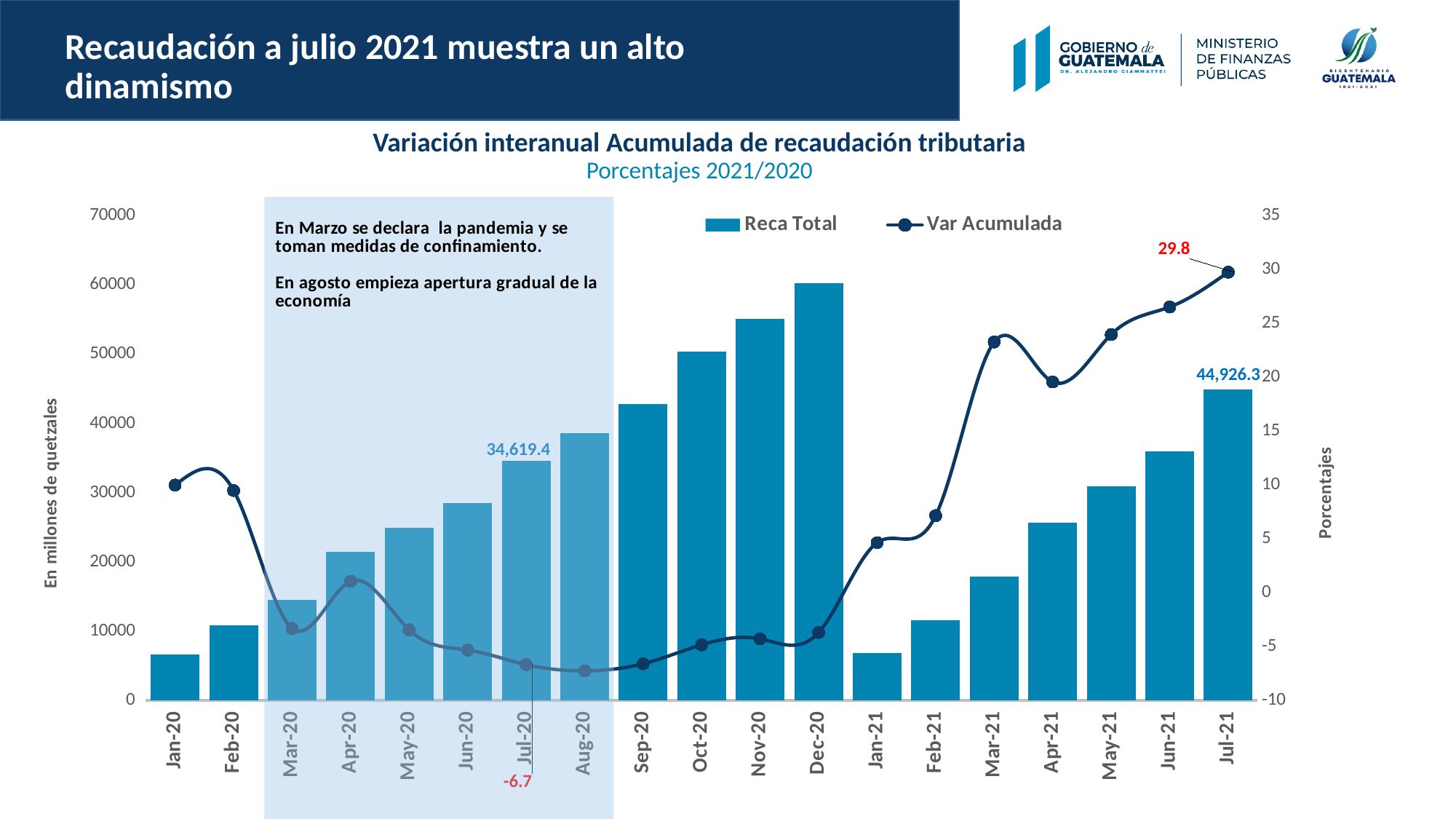
Is the Var Acumulada value for Mar-21 greater or less than 20? greater What is the Var Acumulada value labelled for Jul-21? 29.8 Which has the larger Reca Total bar, Oct-20 or Nov-20? Nov-20 How many months are shown on the x axis? 19 Is the Reca Total value for Dec-20 greater or less than 50000? greater What is the Reca Total value labelled for Jul-20? 34,619.4 Which month has the highest Var Acumulada value? Jul-21 What is the Var Acumulada value labelled for Jul-20? -6.7 Which month has the highest Reca Total bar? Dec-20 How many series does the legend list? 2 What is the Reca Total value labelled for Jul-21? 44,926.3 What is the difference between the Reca Total values labelled for Jul-21 and Jul-20? 10,306.9